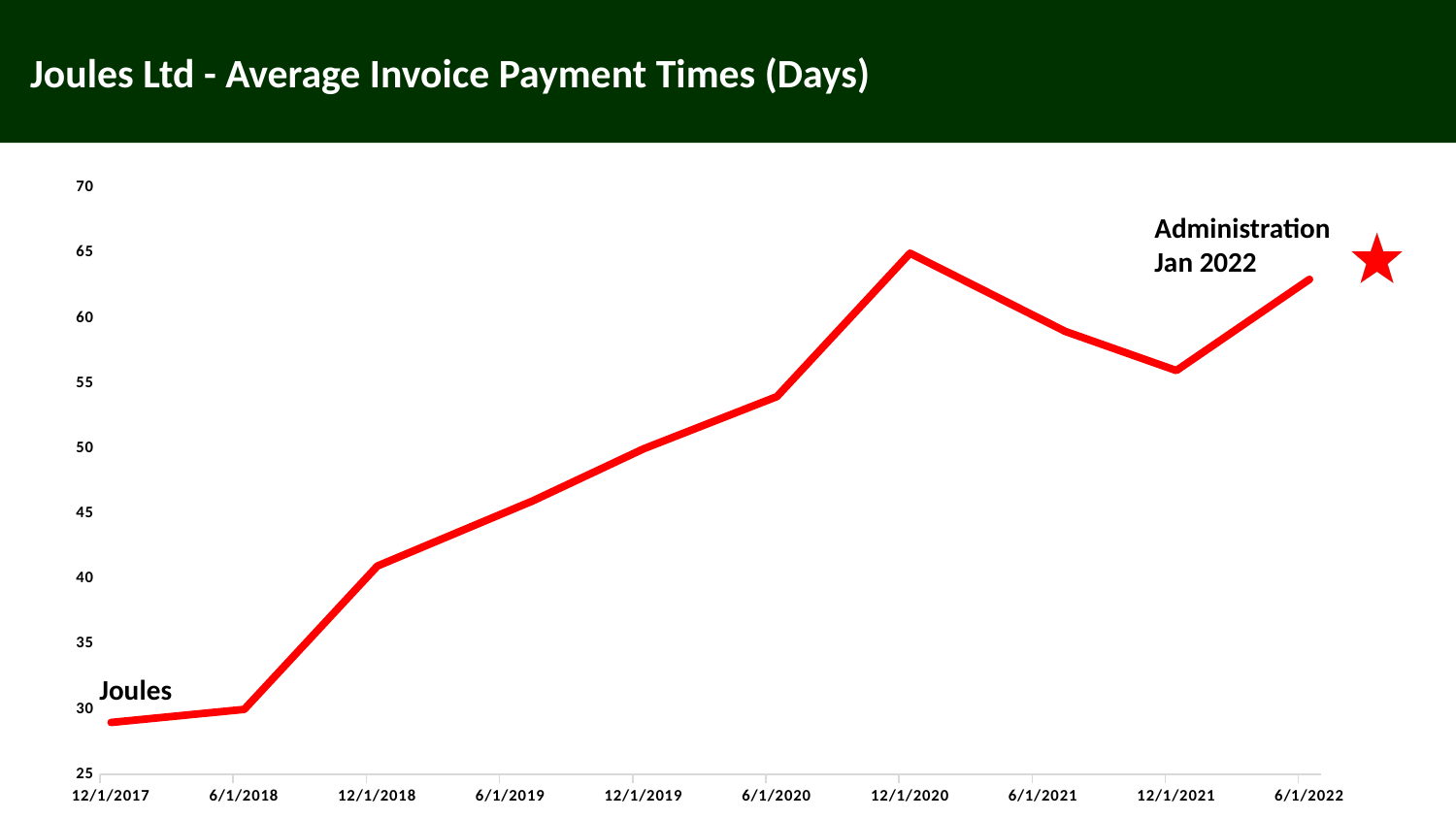
Is the value for 6/1/2022 greater or less than 60? greater Which is larger, the value for 12/1/2020 or the value for 12/1/2021? 12/1/2020 Is the value for 6/1/2020 greater or less than 50? greater Which date has the lowest average invoice payment time? 12/1/2017 Which date has the highest average invoice payment time? 12/1/2020 Is the value for 12/1/2018 greater or less than 35? greater Overall, do the average invoice payment times rise or fall from 12/1/2017 to 6/1/2022? Rise What kind of chart is shown on the slide? Line chart How many dates are labelled along the x axis of the chart? 10 What event is annotated near the end of the line on the chart? Administration Jan 2022 Which is larger, the value for 6/1/2019 or the value for 6/1/2021? 6/1/2021